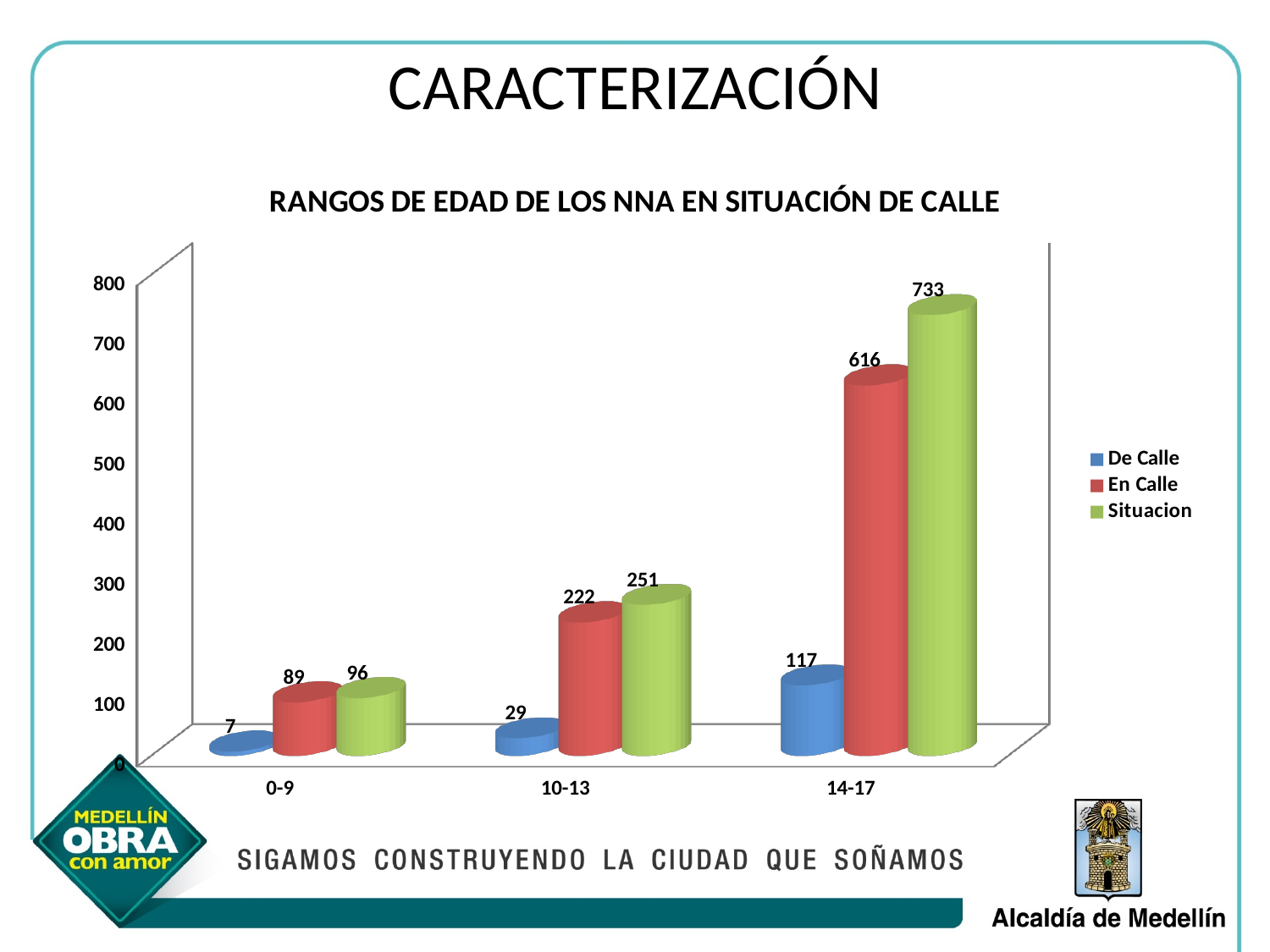
Which age range has the lowest value for 'De Calle'? 0-9 How many age ranges are shown on the x axis? 3 Do the 'De Calle' values rise or fall from the 0-9 to the 14-17 age range? Rise How many series does the legend list? 3 What is the difference between 'Situacion' and 'En Calle' in the 14-17 age range? 117 What is the value for 'De Calle' in the 0-9 age range? 7 Which is larger in the 10-13 age range, 'En Calle' or 'Situacion'? Situacion What kind of chart is shown on the slide? Bar chart What is the value for 'Situacion' in the 10-13 age range? 251 Is the value for 'En Calle' in the 14-17 age range greater or less than 600? greater What is the value for 'En Calle' in the 14-17 age range? 616 Which age range has the highest value for 'Situacion'? 14-17